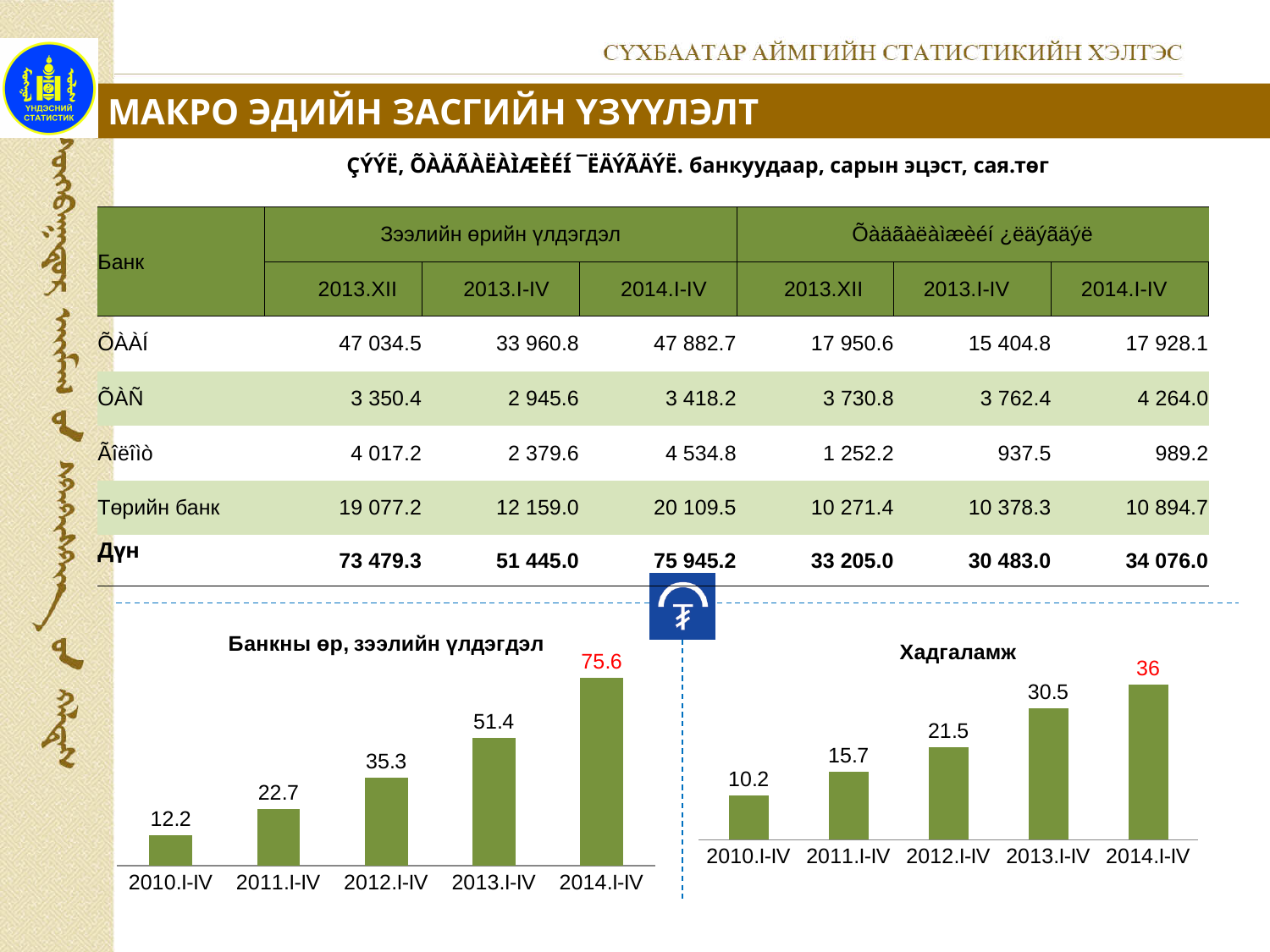
In the 'Банкны өр, зээлийн үлдэгдэл' chart, what is the value for 2014.I-IV? 75.6 In the 'Банкны өр, зээлийн үлдэгдэл' chart, what is the value for 2011.I-IV? 22.7 In the 'Хадгаламж' chart, what is the difference between the values for 2013.I-IV and 2012.I-IV? 9 In the 'Хадгаламж' chart, what is the value for 2014.I-IV? 36 How many periods are shown in the 'Хадгаламж' chart? 5 Which is larger: the 2012.I-IV value in the 'Банкны өр, зээлийн үлдэгдэл' chart or the 2012.I-IV value in the 'Хадгаламж' chart? Банкны өр, зээлийн үлдэгдэл In the 'Банкны өр, зээлийн үлдэгдэл' chart, what is the difference between the values for 2014.I-IV and 2013.I-IV? 24.2 In the 'Хадгаламж' chart, what is the value for 2012.I-IV? 21.5 In the 'Хадгаламж' chart, which period has the highest value? 2014.I-IV In the 'Банкны өр, зээлийн үлдэгдэл' chart, which period has the lowest value? 2010.I-IV In the 'Хадгаламж' chart, do the values rise or fall from 2010.I-IV to 2014.I-IV? rise What kind of chart is the 'Банкны өр, зээлийн үлдэгдэл' chart? bar chart